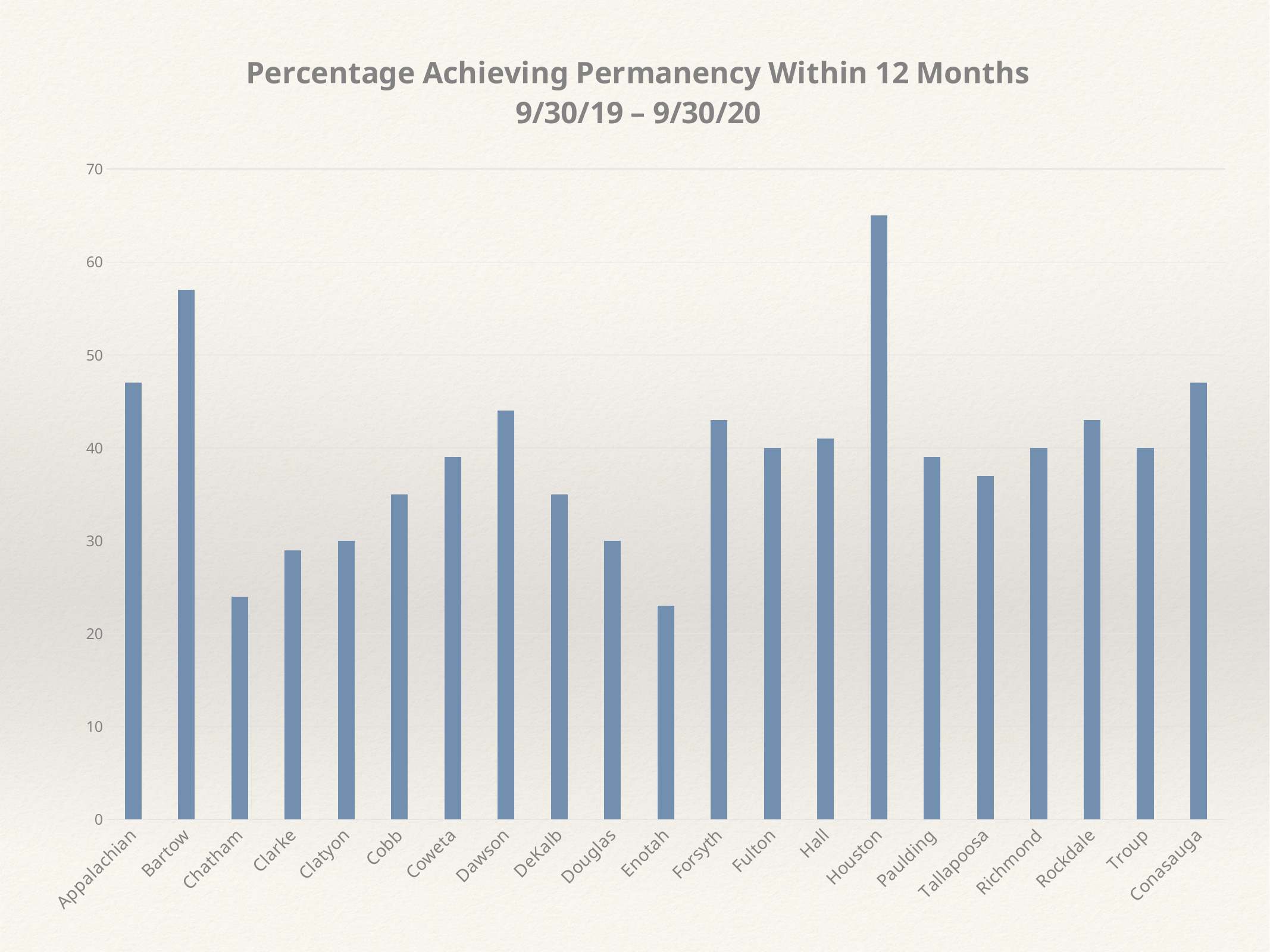
How many categories (circuits) are shown on the x axis? 21 What kind of chart is shown on the slide? Bar chart Is the value for Cobb greater or less than 40? less Is the value for Bartow greater or less than 50? greater Which category has the highest value? Houston What is the title of the chart? Percentage Achieving Permanency Within 12 Months 9/30/19 – 9/30/20 Which is larger, the value for Dawson or the value for Coweta? Dawson Is the value for Enotah greater or less than 30? less Which is larger, the value for Bartow or the value for Appalachian? Bartow